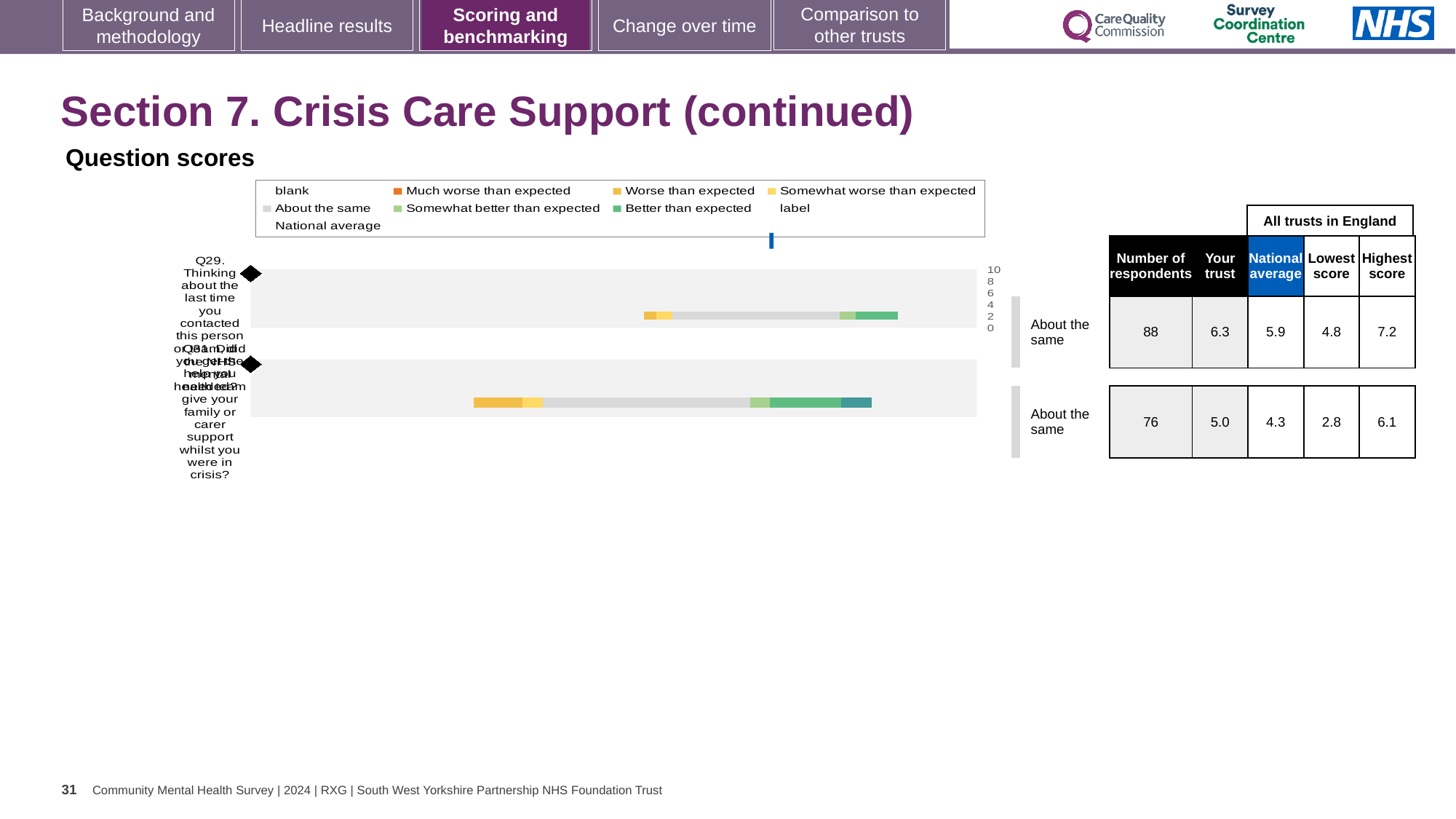
In the table next to the chart, what is the highest score among all trusts in England for Q31? 6.1 In the table next to the chart, what is the national average for Q31? 4.3 In the table next to the chart, what is the lowest score among all trusts in England for Q29? 4.8 How many questions (categories) are plotted in the question scores chart? 2 What is the difference between the 'Your trust' score and the national average for Q31 in the table? 0.7 What kind of chart is used to show the question scores on this slide? bar chart Which question has the higher 'Your trust' score in the table, Q29 or Q31? Q29 In the table next to the chart, what is the number of respondents for Q29? 88 What is the highest value shown on the chart's score axis? 10 In the table next to the chart, what is the 'Your trust' score for Q29? 6.3 What is the benchmark category shown for Q29 and Q31 next to the chart? About the same What is the difference between the highest and lowest scores for Q29 in the table? 2.4